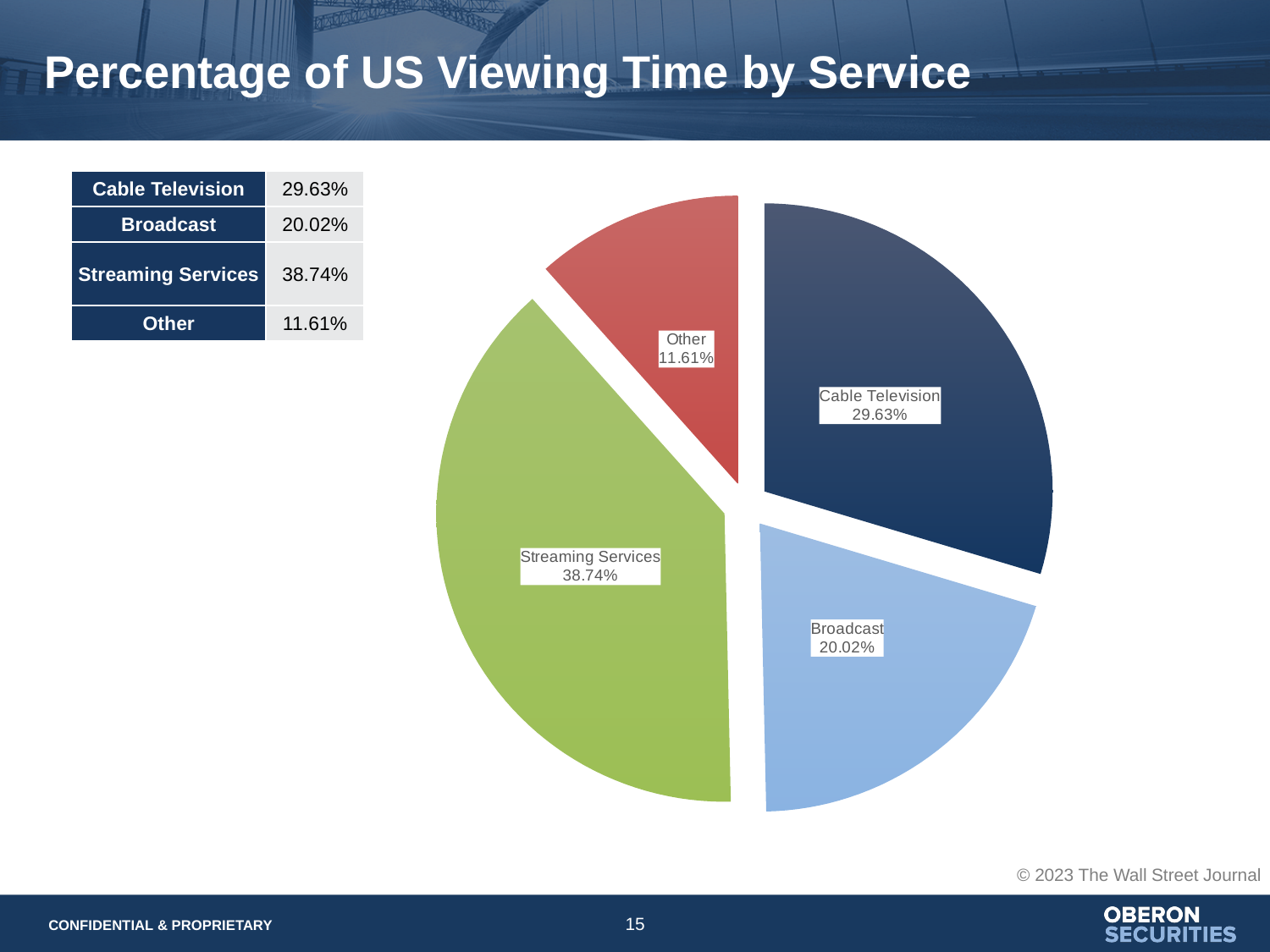
Which service has the largest share of US viewing time? Streaming Services What is the value shown for Broadcast? 20.02% What colour is the Streaming Services slice? green What is the value shown for the Other slice? 11.61% What is the value shown for Cable Television? 29.63% What kind of chart is shown on the slide? pie chart What percentage of US viewing time does Streaming Services account for? 38.74% What is the difference between the Broadcast share and the Other share? 8.41% Which category has the smallest slice of the pie? Other What is the difference between the Streaming Services share and the Cable Television share? 9.11% How many slices does the pie chart have? 4 Which is larger, the share for Cable Television or the share for Broadcast? Cable Television